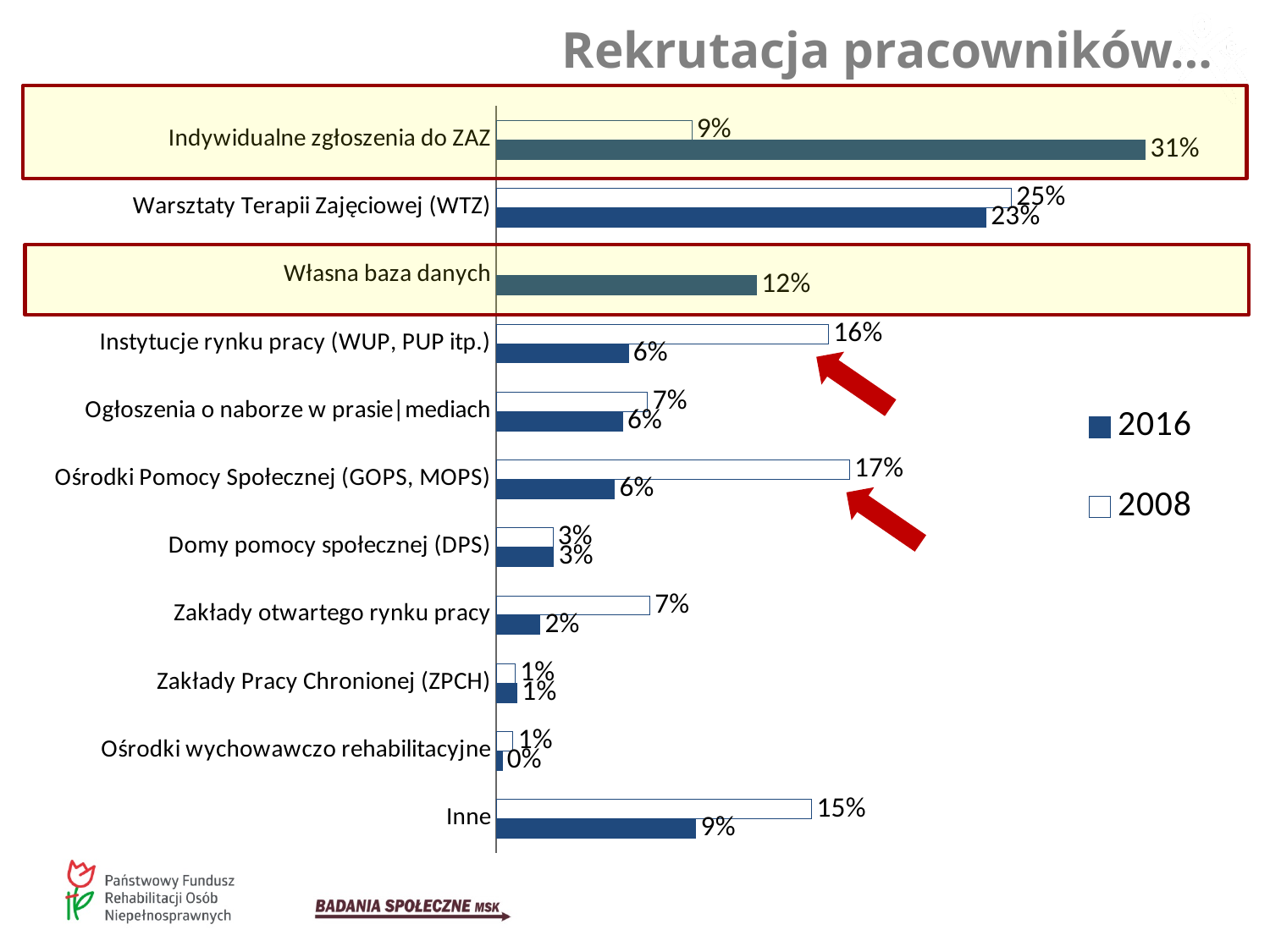
How many series does the legend list? 2 What is the difference between the 2008 and 2016 values for Instytucje rynku pracy (WUP, PUP itp.)? 10% How many categories are shown on the chart? 11 What is the 2008 value for Inne? 15% What is the 2016 value for Własna baza danych? 12% What is the 2008 value for Ośrodki Pomocy Społecznej (GOPS, MOPS)? 17% What is the 2016 value for Indywidualne zgłoszenia do ZAZ? 31% What is the difference between the 2016 and 2008 values for Indywidualne zgłoszenia do ZAZ? 22% Which category has the highest 2016 value? Indywidualne zgłoszenia do ZAZ What kind of chart is shown on the slide? Bar chart For Warsztaty Terapii Zajęciowej (WTZ), which year has the larger value, 2016 or 2008? 2008 Which category has the highest 2008 value? Warsztaty Terapii Zajęciowej (WTZ)